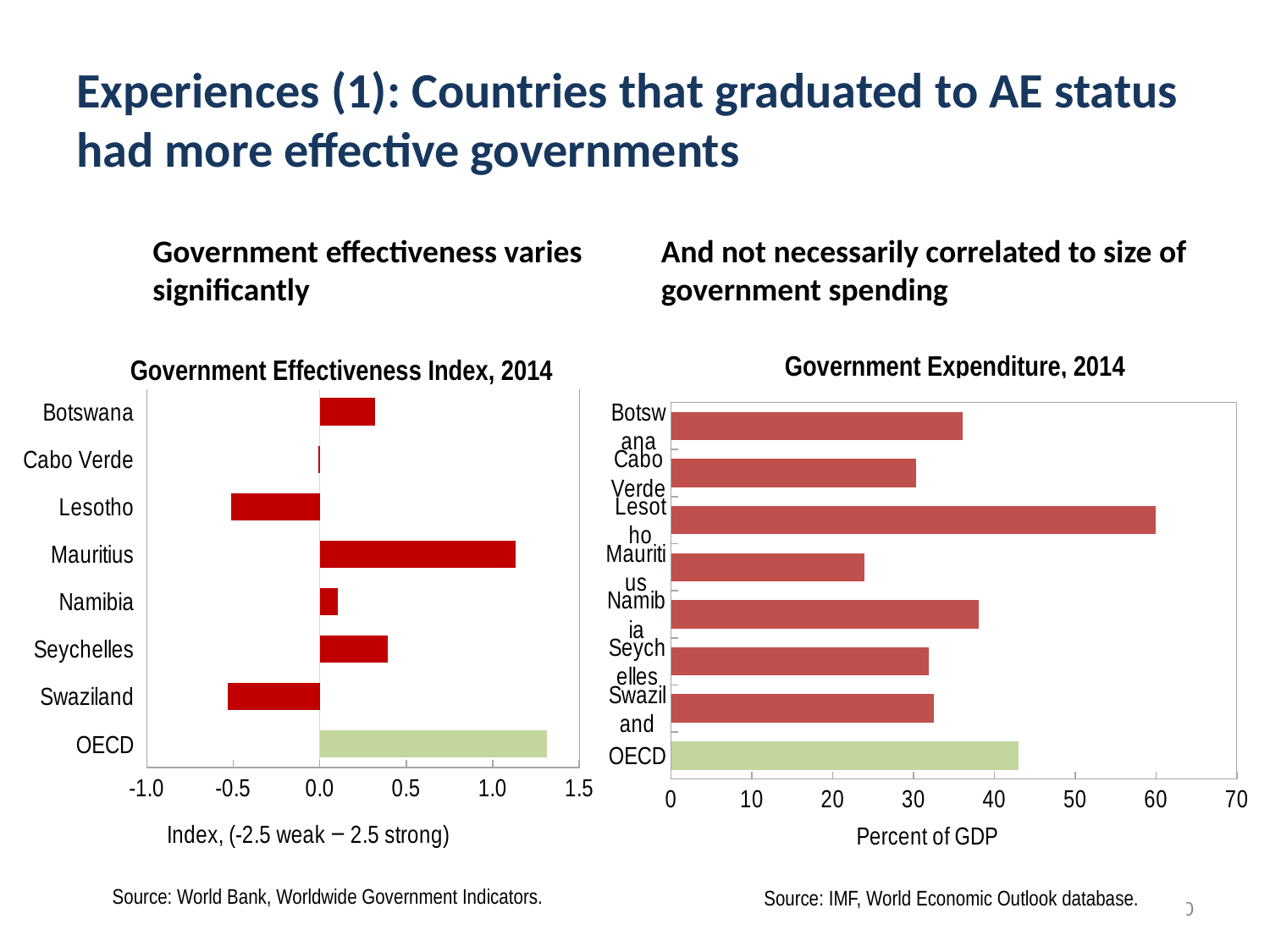
In the Government Effectiveness Index, 2014 chart, which category has the highest value? OECD In the Government Expenditure, 2014 chart, is the value for OECD greater or less than 40? greater In the Government Effectiveness Index, 2014 chart, which is larger, the value for Botswana or the value for Namibia? Botswana In the Government Effectiveness Index, 2014 chart, what kind of chart is used? bar chart In the Government Expenditure, 2014 chart, which category has the highest value? Lesotho In the Government Effectiveness Index, 2014 chart, which country other than OECD has the highest value? Mauritius In the Government Expenditure, 2014 chart, which category has the lowest value? Mauritius In the Government Expenditure, 2014 chart, which is larger, the value for Namibia or the value for Cabo Verde? Namibia In the Government Effectiveness Index, 2014 chart, is the value for Lesotho greater or less than 0.0? less In the Government Effectiveness Index, 2014 chart, how many categories are plotted? 8 In the Government Expenditure, 2014 chart, what is the x-axis label? Percent of GDP In the Government Effectiveness Index, 2014 chart, is the value for Mauritius greater or less than 1.0? greater